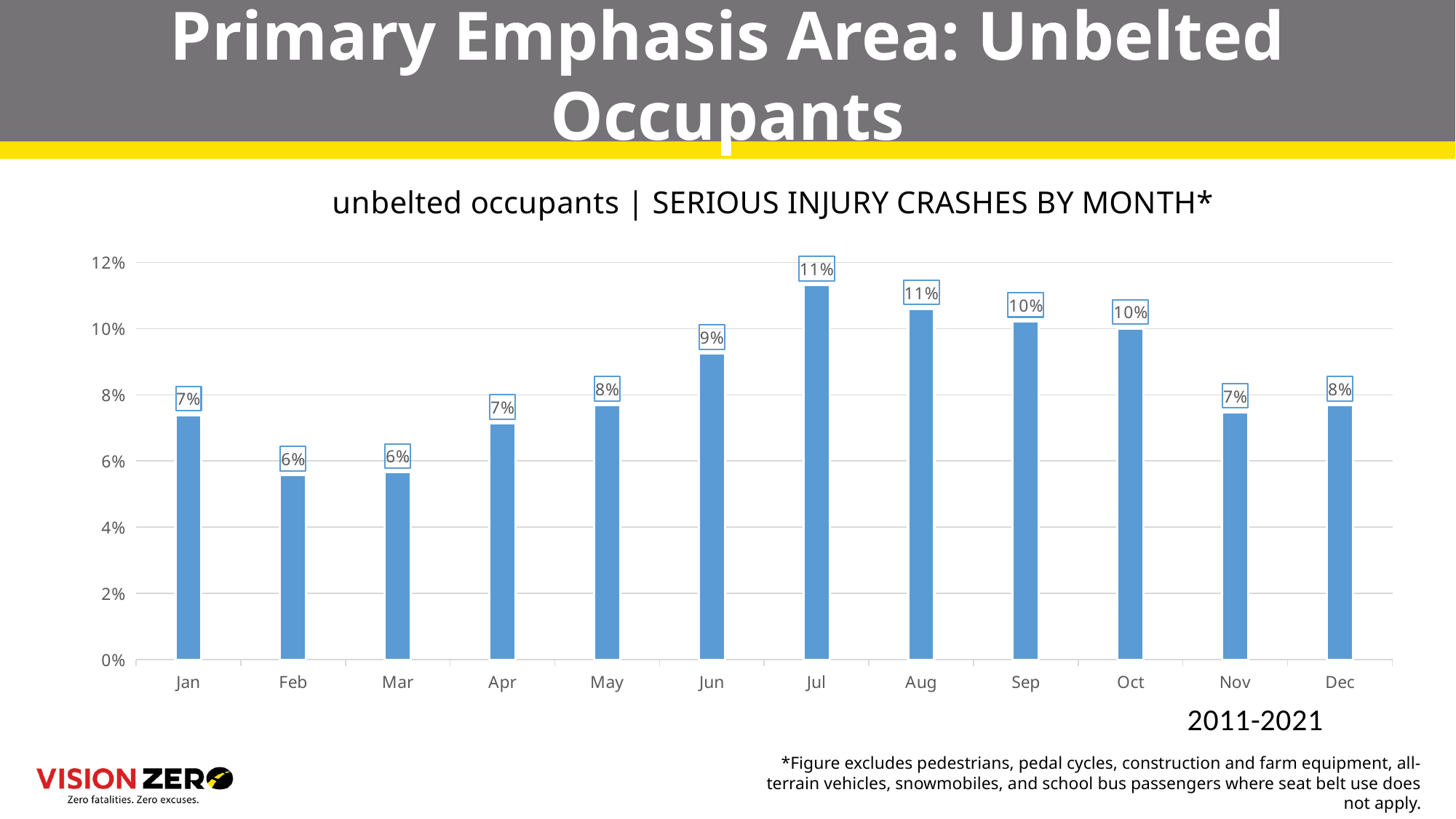
Which month has the highest value? Jul What is the value for Jul? 11% Is the value for Jul greater or less than 10%? greater What is the value for Sep? 10% What is the value for Dec? 8% How many months are shown on the x axis? 12 Do the values rise or fall from Jan to Jul? rise Is the value for Jun greater or less than 10%? less What is the value for Feb? 6% Which is larger, the value for Jun or the value for Apr? Jun What is the difference between the values for Jul and Feb? 5% What kind of chart is shown on the slide? bar chart